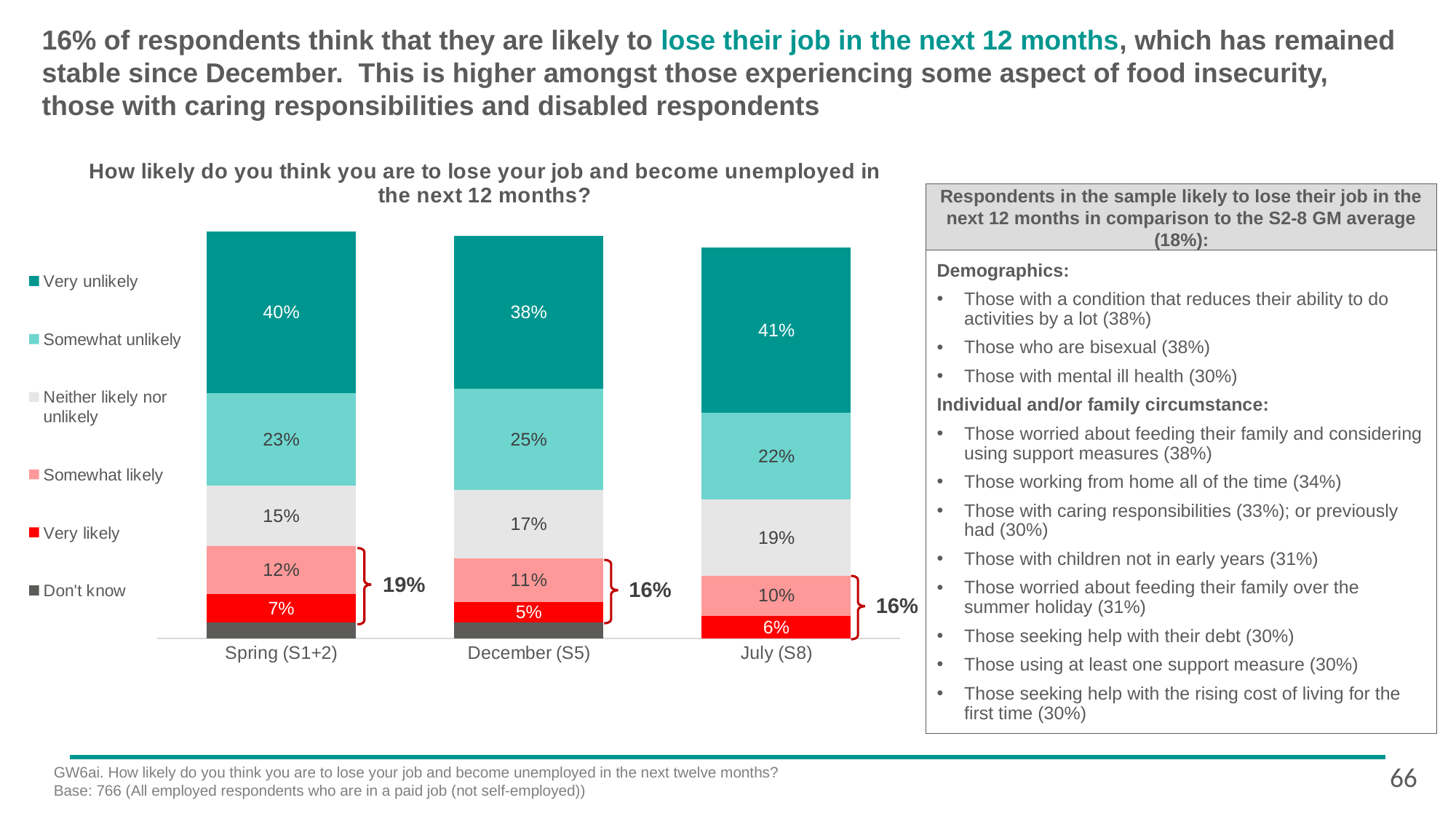
Is the 'Somewhat unlikely' percentage larger in December (S5) or in July (S8)? December (S5) How many series does the chart legend list? 6 Which survey wave has the lowest 'Very likely' percentage? December (S5) Which survey wave has the highest 'Very unlikely' percentage? July (S8) What percentage of respondents said 'Very unlikely' in July (S8)? 41% What is the difference between the 'Neither likely nor unlikely' percentages for July (S8) and Spring (S1+2)? 4 percentage points What kind of chart is used to show how likely respondents think they are to lose their job? Stacked bar chart How many survey waves are shown on the x axis of the chart? 3 What is the combined 'likely' figure (Somewhat likely plus Very likely) shown by the bracket for Spring (S1+2)? 19% What percentage of respondents said 'Somewhat likely' in Spring (S1+2)? 12% Which legend entry is shown in red? Very likely What percentage of respondents said 'Very likely' in December (S5)? 5%